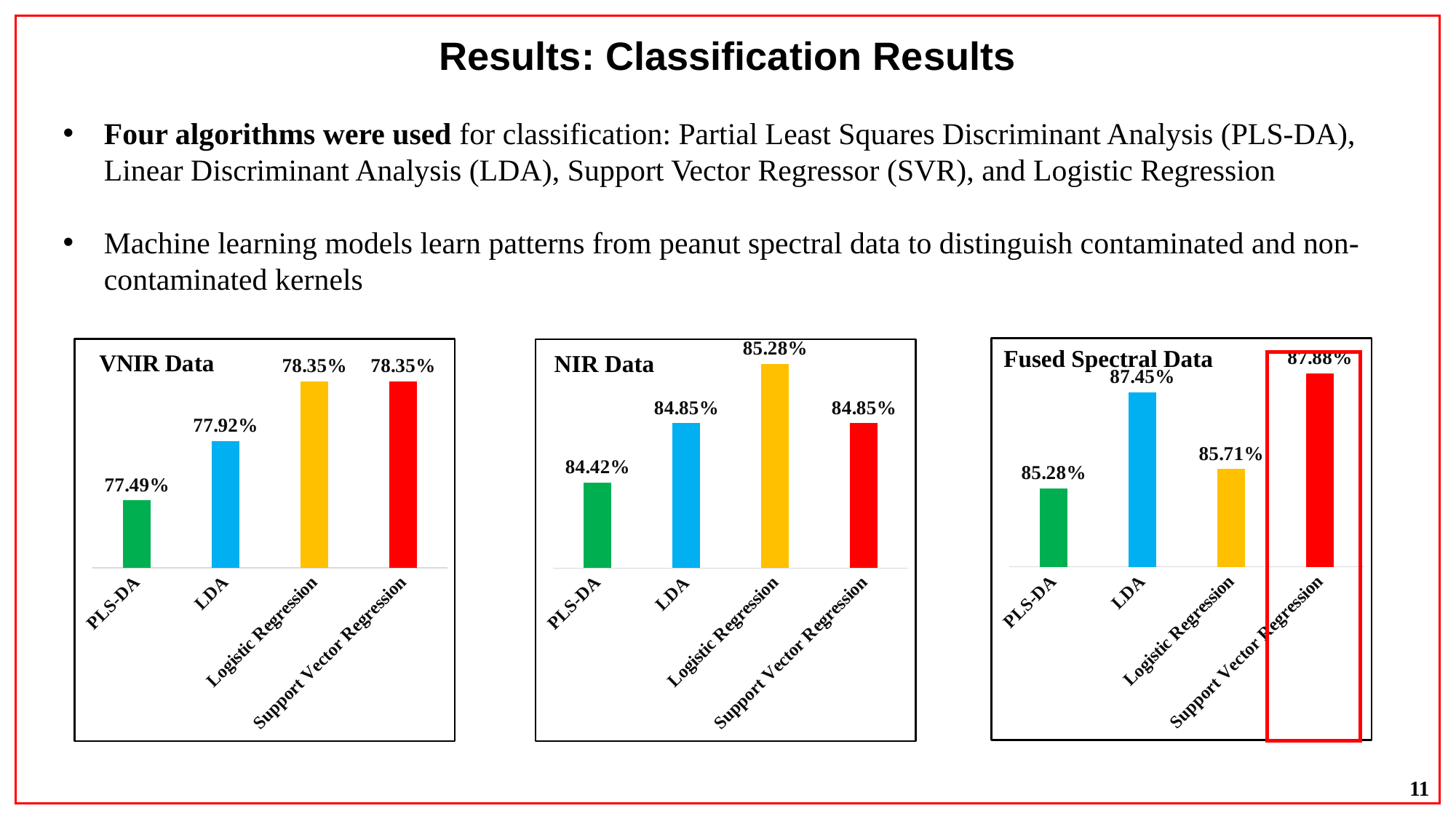
How many categories are shown in the VNIR Data chart? 4 What kind of chart is the NIR Data chart? Bar chart In the Fused Spectral Data chart, what is the value for Logistic Regression? 85.71% In the NIR Data chart, which category has the highest value? Logistic Regression In the NIR Data chart, which is larger: the value for LDA or the value for PLS-DA? LDA In the Fused Spectral Data chart, which bar is outlined with a red box? Support Vector Regression In the Fused Spectral Data chart, which category has the highest value? Support Vector Regression In the VNIR Data chart, what is the value for LDA? 77.92% In the Fused Spectral Data chart, what is the difference between the Support Vector Regression value and the LDA value? 0.43% In the VNIR Data chart, what is the value for PLS-DA? 77.49% In the NIR Data chart, what is the value for PLS-DA? 84.42% In the Fused Spectral Data chart, which category has the lowest value? PLS-DA